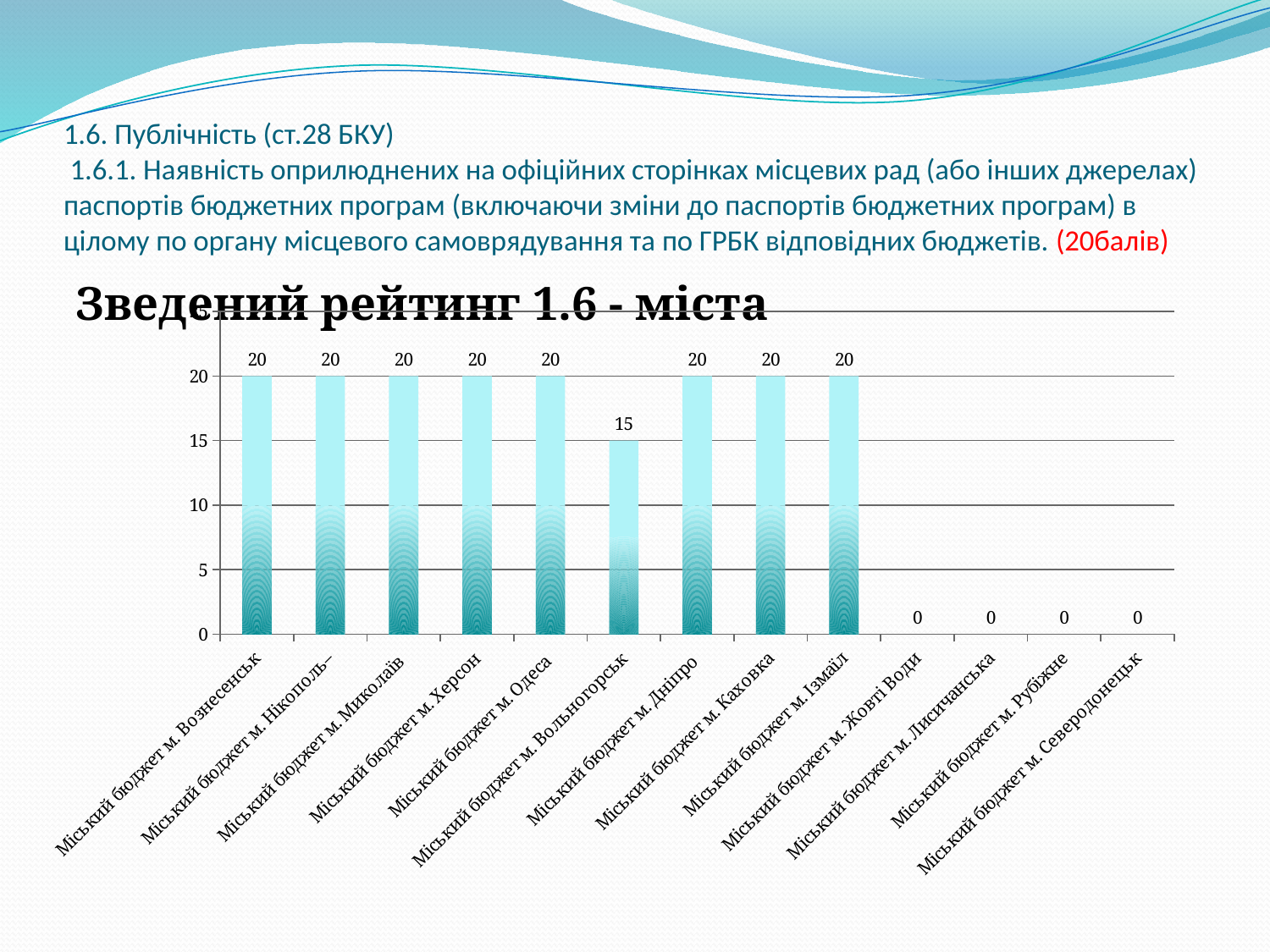
What is the difference between the values for Міський бюджет м. Дніпро and Міський бюджет м. Вольногорськ? 5 What is the value for Міський бюджет м. Северодонецьк? 0 Which is larger, the value for Міський бюджет м. Херсон or the value for Міський бюджет м. Вольногорськ? Міський бюджет м. Херсон What is the value for Міський бюджет м. Одеса? 20 Is the value for Міський бюджет м. Вольногорськ greater or less than 10? greater What is the value for Міський бюджет м. Каховка? 20 Which is larger, the value for Міський бюджет м. Ізмаїл or the value for Міський бюджет м. Рубіжне? Міський бюджет м. Ізмаїл What is the title of the chart? Зведений рейтинг 1.6 - міста What kind of chart is shown on the slide? bar chart How many categories are shown on the x axis of the chart? 13 What is the value for Міський бюджет м. Вольногорськ? 15 What is the value for Міський бюджет м. Жовті Води? 0